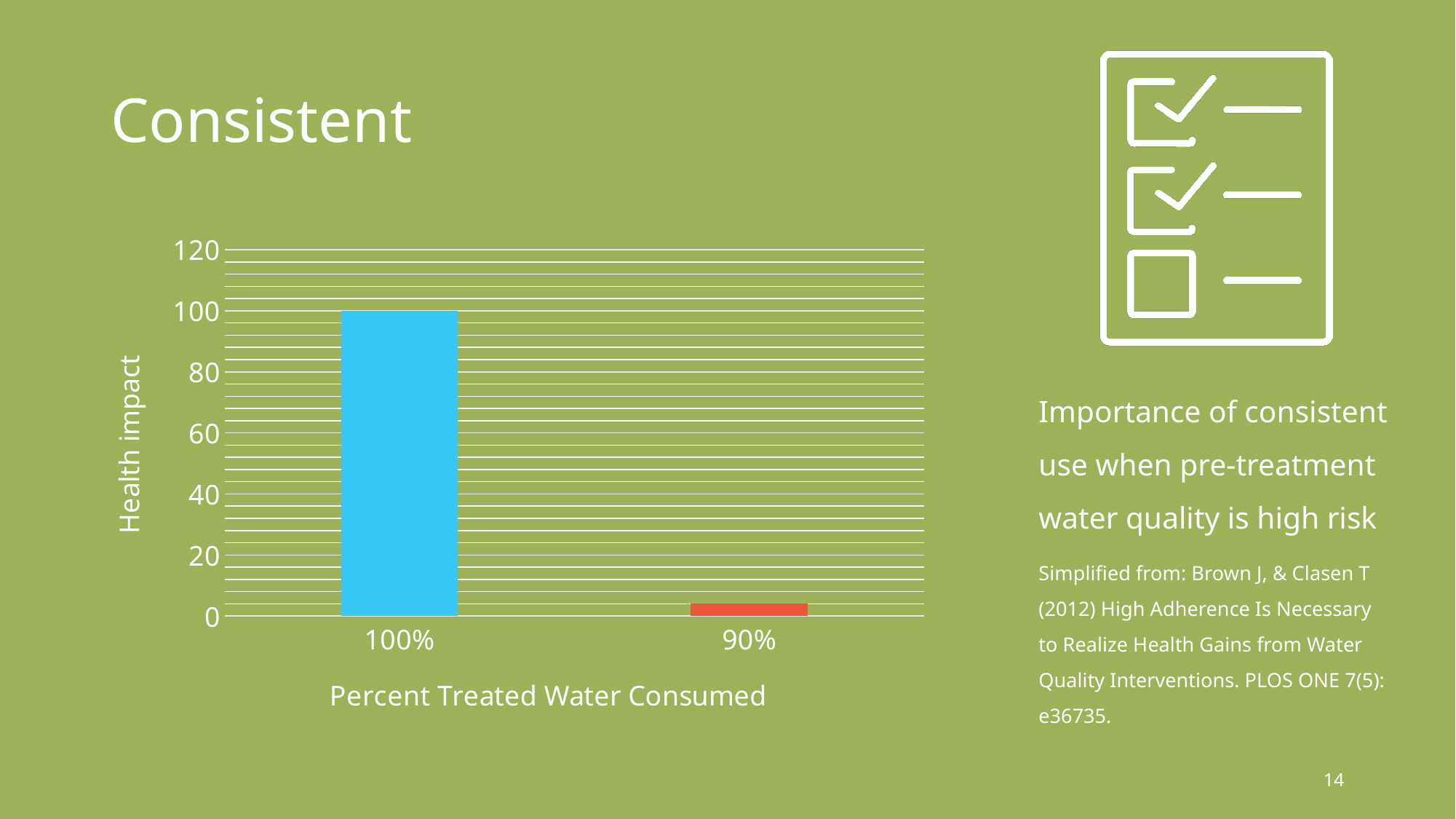
How many categories are plotted on the x axis? 2 Which has a larger health impact, 100% or 90% treated water consumed? 100% Do the values rise or fall moving from 100% to 90% along the x axis? fall What kind of chart is shown on the slide? bar chart Is the health impact value for 100% treated water consumed greater or less than 80? greater What is the title of the x axis? Percent Treated Water Consumed What is the title of the y axis? Health impact What is the health impact value for 100% treated water consumed? 100 Is the health impact value for 90% treated water consumed greater or less than 20? less Which category has the highest health impact? 100% Which category has the lowest health impact? 90%